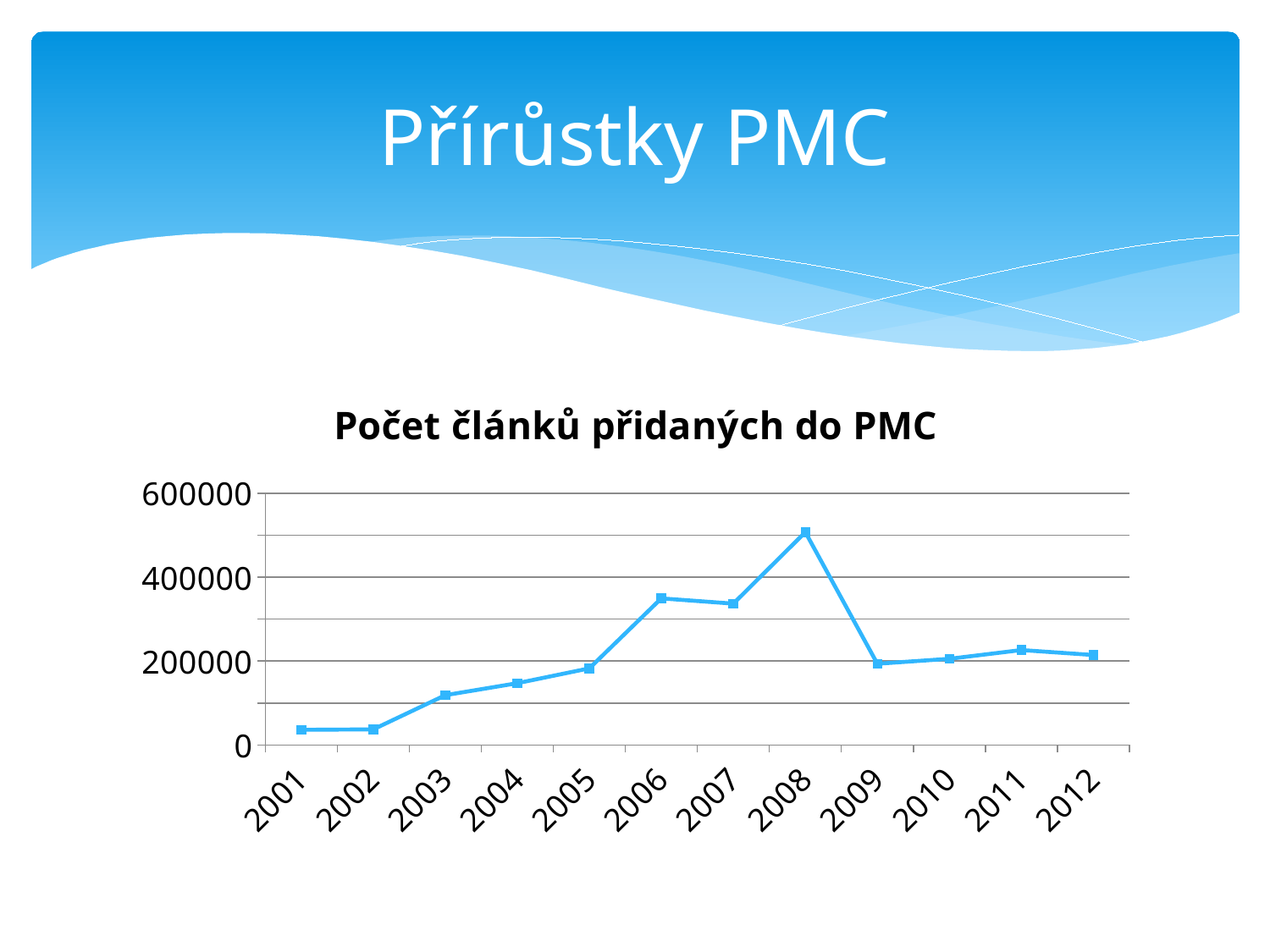
Do the values generally rise or fall from 2001 to 2008? rise Which year has the larger value, 2008 or 2012? 2008 Is the value for 2008 greater or less than 400000? greater Which year has the highest value in the chart? 2008 Is the value for 2001 greater or less than 200000? less Is the value for 2007 greater or less than 400000? less Which year has the larger value, 2006 or 2009? 2006 What is the title of the chart? Počet článků přidaných do PMC What kind of chart is shown on the slide? line chart How many years are plotted on the x axis of the chart? 12